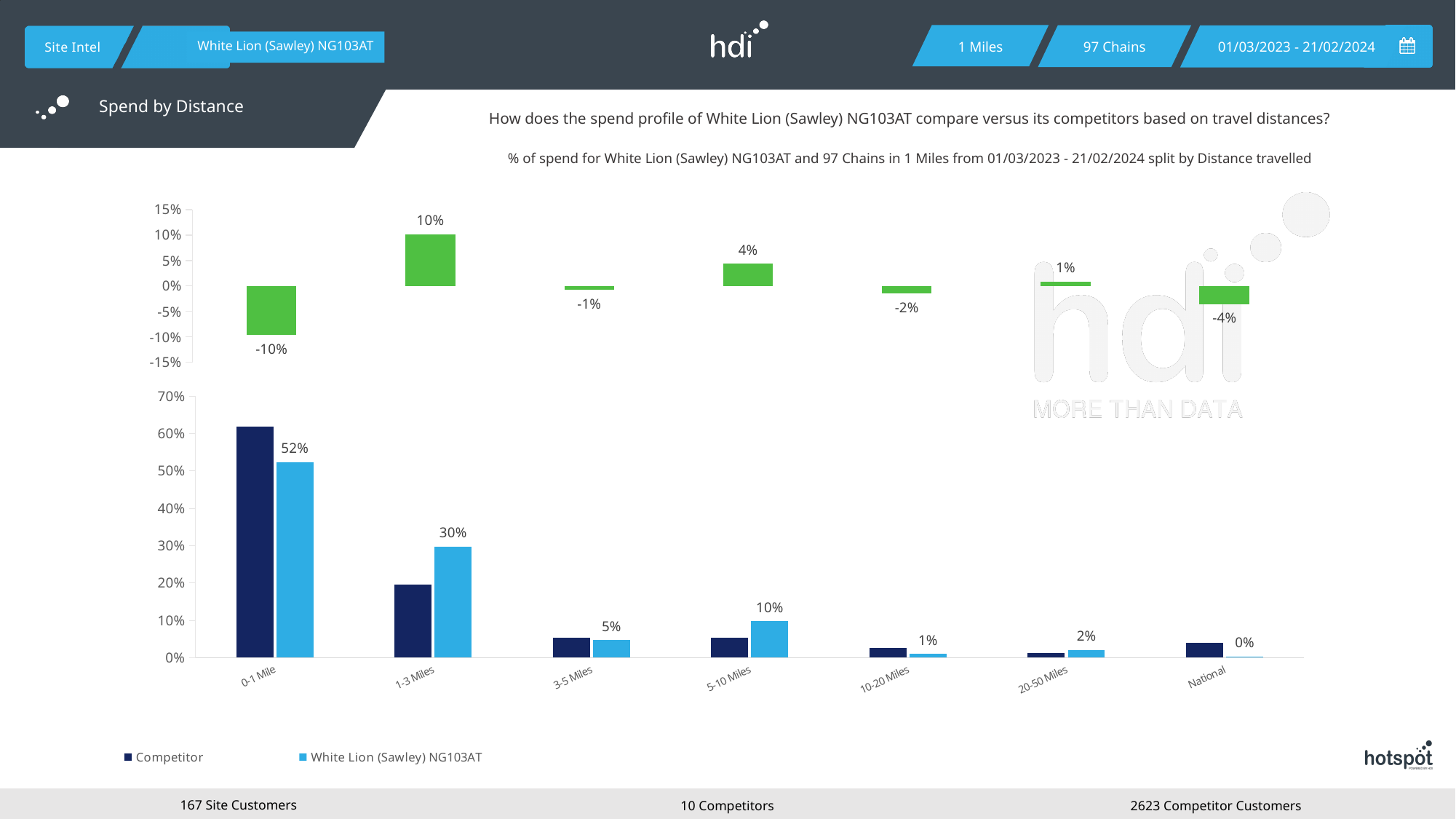
In the top chart, what is the value shown for 0-1 Mile? -10% In the top chart, which category has the highest value? 1-3 Miles What kind of chart is the bottom chart? Bar chart In the bottom chart, what is the value for White Lion (Sawley) NG103AT in the 1-3 Miles category? 30% In the top chart, what is the value shown for 1-3 Miles? 10% In the top chart, which category has the lowest value? 0-1 Mile In the bottom chart, which series has the larger value in the 0-1 Mile category, Competitor or White Lion (Sawley) NG103AT? Competitor In the bottom chart, is the Competitor value for 0-1 Mile greater or less than 60%? greater How many distance categories are shown on the x axis of the bottom chart? 7 In the bottom chart, what is the difference between the White Lion (Sawley) NG103AT values for 0-1 Mile and 1-3 Miles? 22 percentage points How many series does the legend of the bottom chart list? 2 In the bottom chart, what is the value for White Lion (Sawley) NG103AT in the 0-1 Mile category? 52%